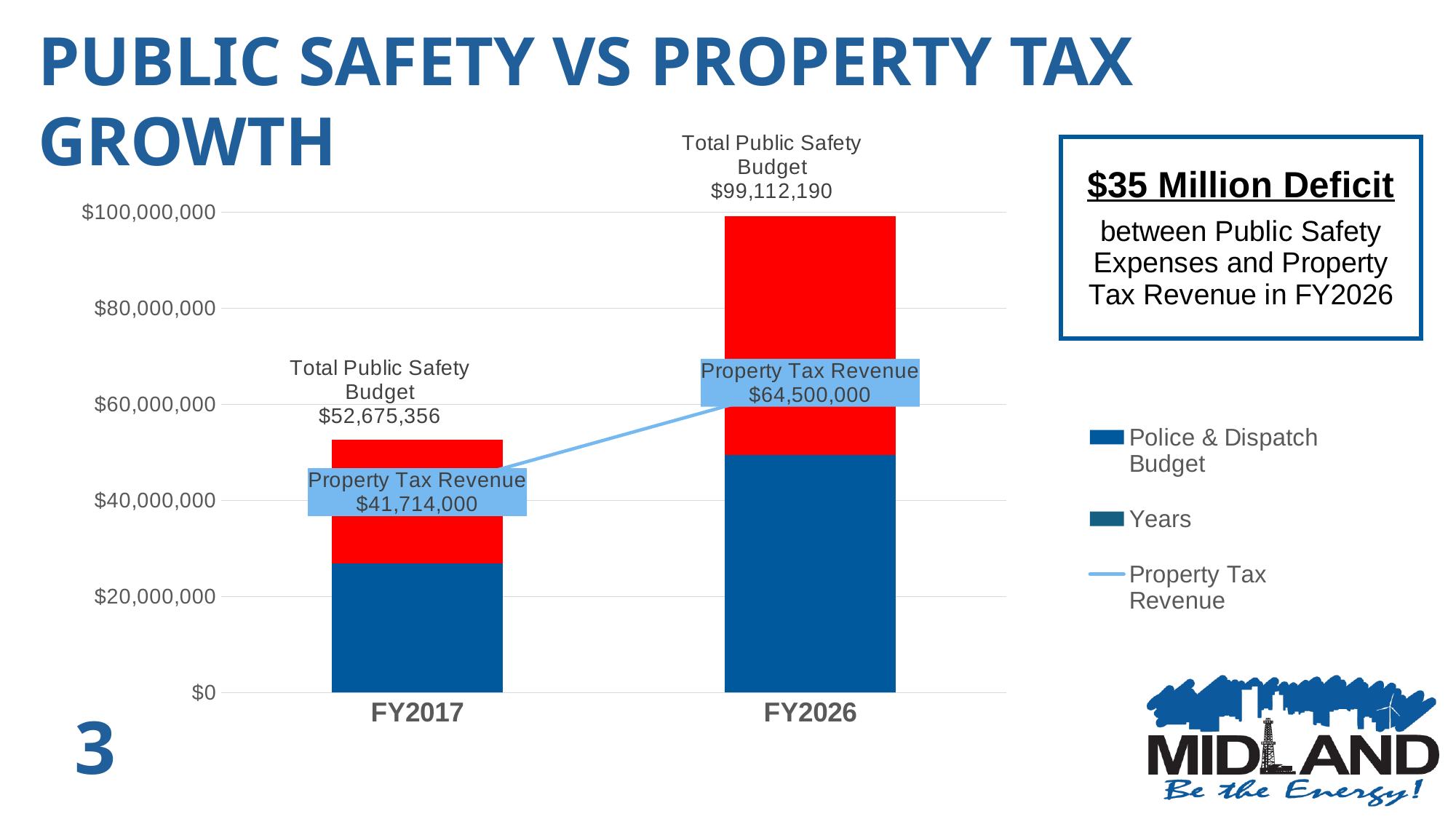
How many entries does the chart legend list? 3 How many fiscal years are shown on the x axis of the chart? 2 What is the difference between Property Tax Revenue in FY2026 and FY2017? $22,786,000 What is the Total Public Safety Budget for FY2017? $52,675,356 What is the Property Tax Revenue value shown for FY2026? $64,500,000 Is the Police & Dispatch Budget bar for FY2026 greater or less than $40,000,000? greater By how much does the Total Public Safety Budget in FY2026 exceed that of FY2017? $46,436,834 What is the Total Public Safety Budget for FY2026? $99,112,190 Is the Police & Dispatch Budget bar for FY2017 greater or less than $40,000,000? less Does the Property Tax Revenue line rise or fall from FY2017 to FY2026? rise Which fiscal year has the higher Total Public Safety Budget? FY2026 What is the Property Tax Revenue value shown for FY2017? $41,714,000